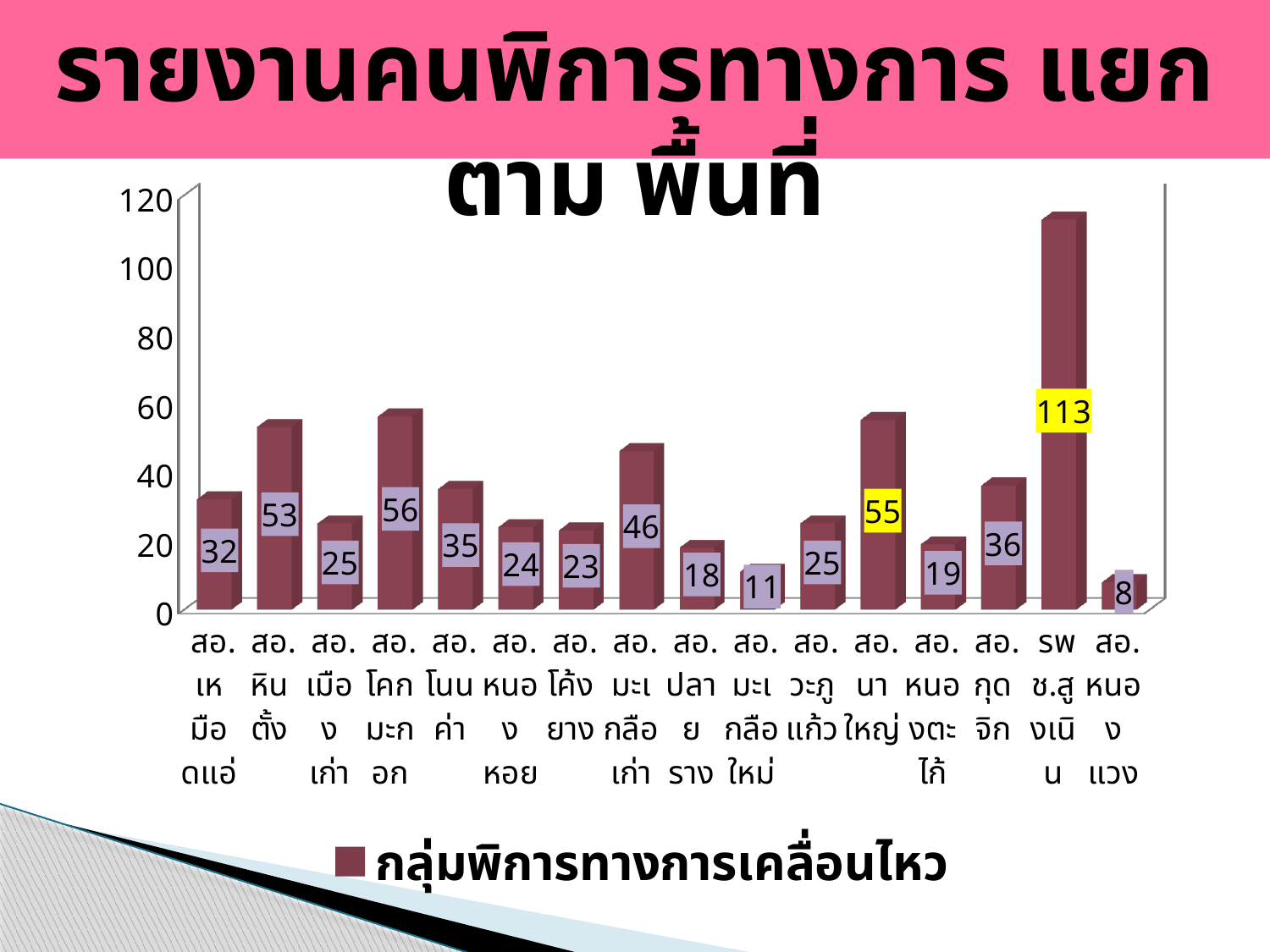
What type of chart is shown on the slide? bar chart How many categories are shown on the x axis? 16 What is the difference between the values for รพช.สูงเนิน and สอ.โคกมะกอก? 57 What is the legend entry for the series? กลุ่มพิการทางการเคลื่อนไหว How many series does the legend list? 1 Which is larger, the value for สอ.หินตั้ง or the value for สอ.กุดจิก? สอ.หินตั้ง Is the value for รพช.สูงเนิน greater or less than 100? greater What is the value for สอ.โคกมะกอก? 56 What is the value for สอ.นาใหญ่? 55 Which category has the highest value? รพช.สูงเนิน Which category has the lowest value? สอ.หนองแวง What is the value for สอ.มะเกลือเก่า? 46